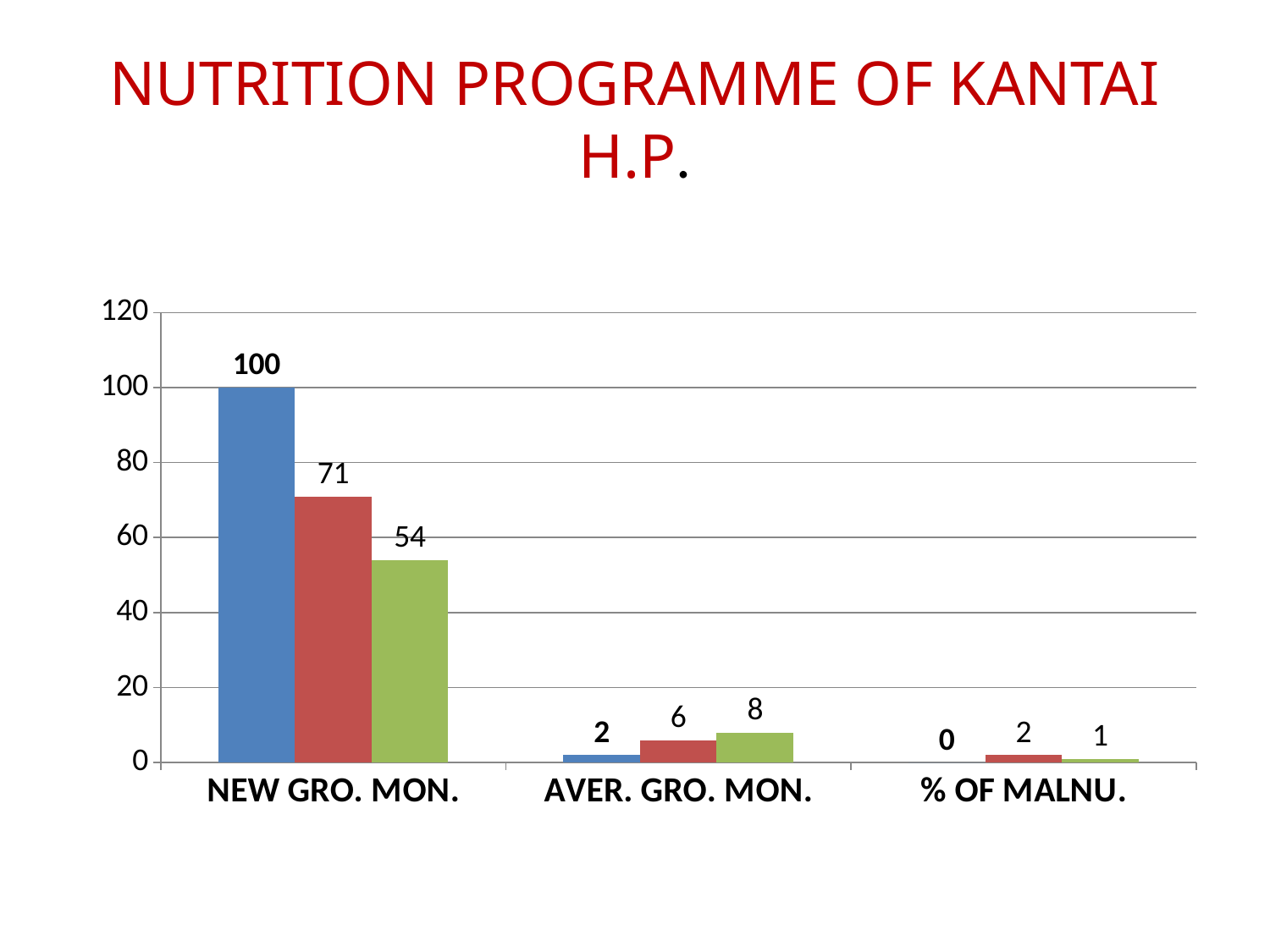
What is the title of the slide containing the chart? NUTRITION PROGRAMME OF KANTAI H.P. Which category has the highest blue bar? NEW GRO. MON. What is the difference between the blue bar and the green bar for NEW GRO. MON.? 46 What is the value of the blue bar for NEW GRO. MON.? 100 What is the value of the red bar for % OF MALNU.? 2 For AVER. GRO. MON., which is larger, the red bar or the green bar? the green bar What is the value of the red bar for NEW GRO. MON.? 71 What is the difference between the red bar and the blue bar for AVER. GRO. MON.? 4 What type of chart is shown on the slide? bar chart Which category has the lowest green bar? % OF MALNU. What is the value of the green bar for AVER. GRO. MON.? 8 How many categories are shown on the x axis of the chart? 3